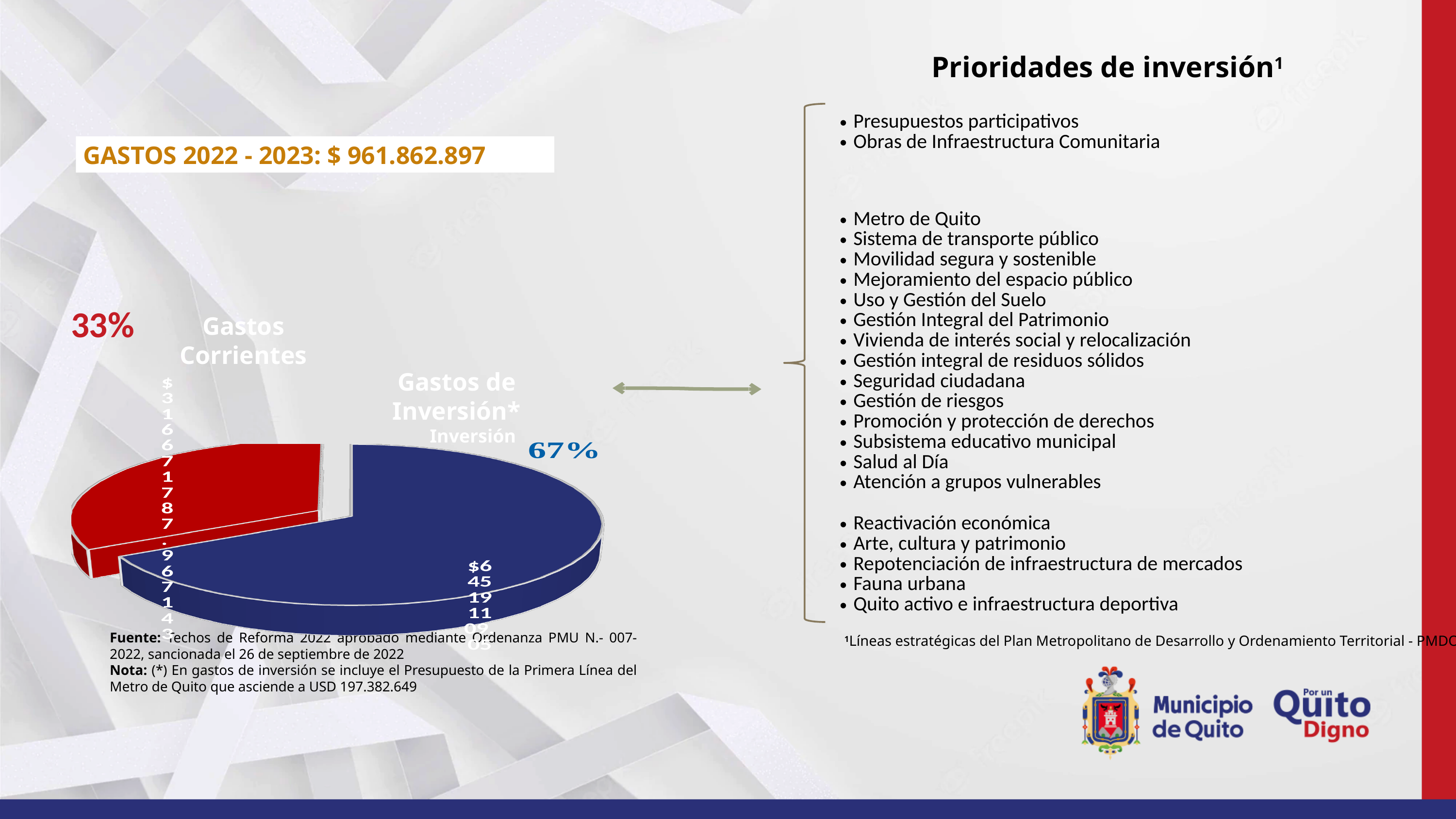
By how many percentage points does the Gastos de Inversión share exceed the Gastos Corrientes share? 34 What share of the pie does Gastos de Inversión represent? 67% What share of the pie does Gastos Corrientes represent? 33% What colour is the Gastos Corrientes slice in the pie chart? red What colour is the Gastos de Inversión slice in the pie chart? blue Which slice of the pie chart is the smallest? Gastos Corrientes Which slice of the pie chart is the largest? Gastos de Inversión What kind of chart is shown on the slide? pie chart How many slices does the pie chart have? 2 Which is larger, the share for Gastos Corrientes or the share for Gastos de Inversión? Gastos de Inversión